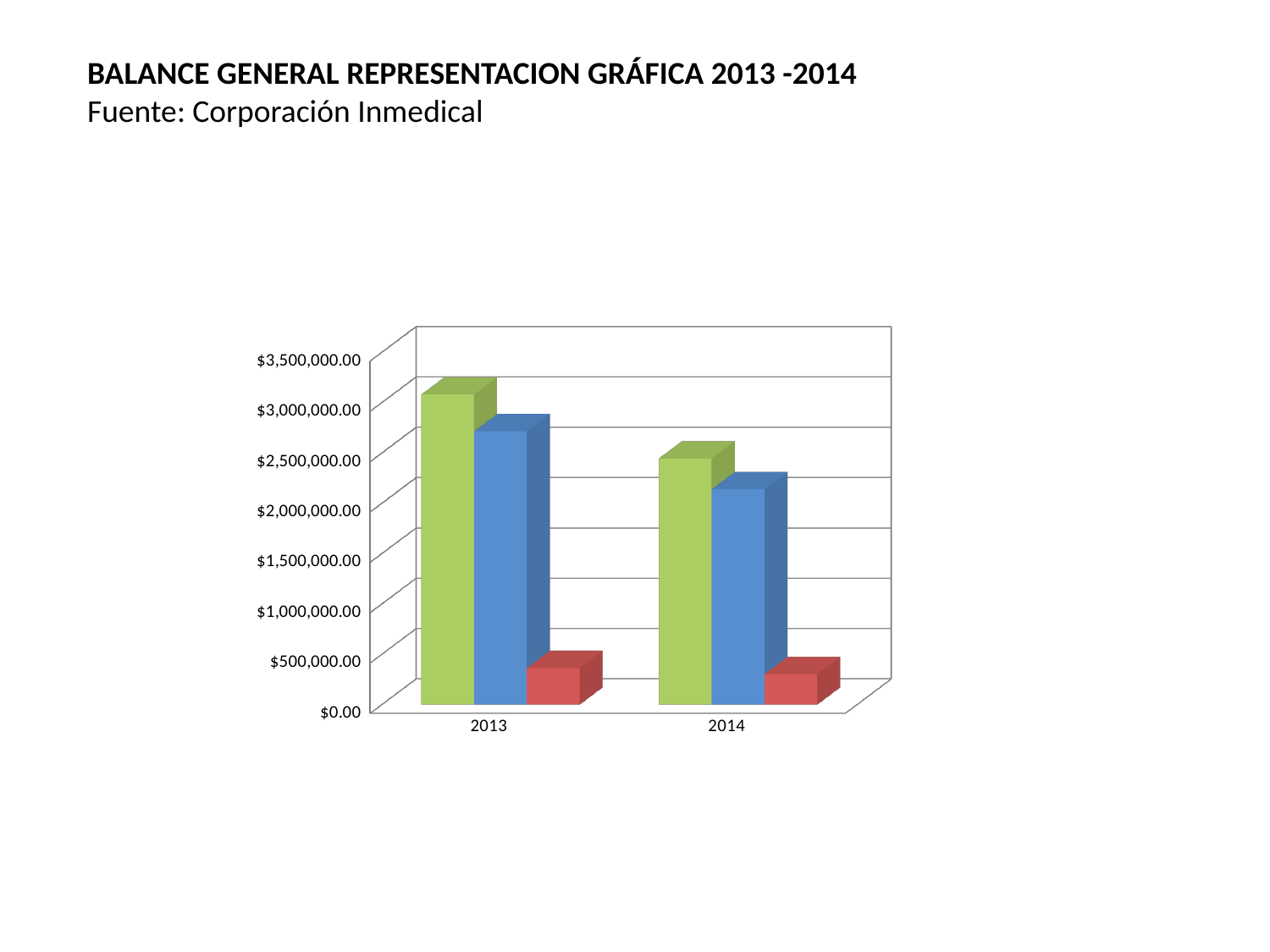
Do the blue bars rise or fall from 2013 to 2014? fall Is the value of the blue bar for 2014 greater or less than $1,500,000.00? greater Is the value of the green bar for 2014 greater or less than $3,000,000.00? less What kind of chart is shown on the slide? bar chart Which coloured bar is the highest for 2013? green Is the green bar for 2013 larger or smaller than the green bar for 2014? larger Is the value of the red bar for 2013 greater or less than $1,000,000.00? less Which coloured bar is the lowest for 2014? red For 2013, is the green bar or the blue bar larger? green How many categories are shown on the x axis of the chart? 2 Which years are shown on the x axis of the chart? 2013 and 2014